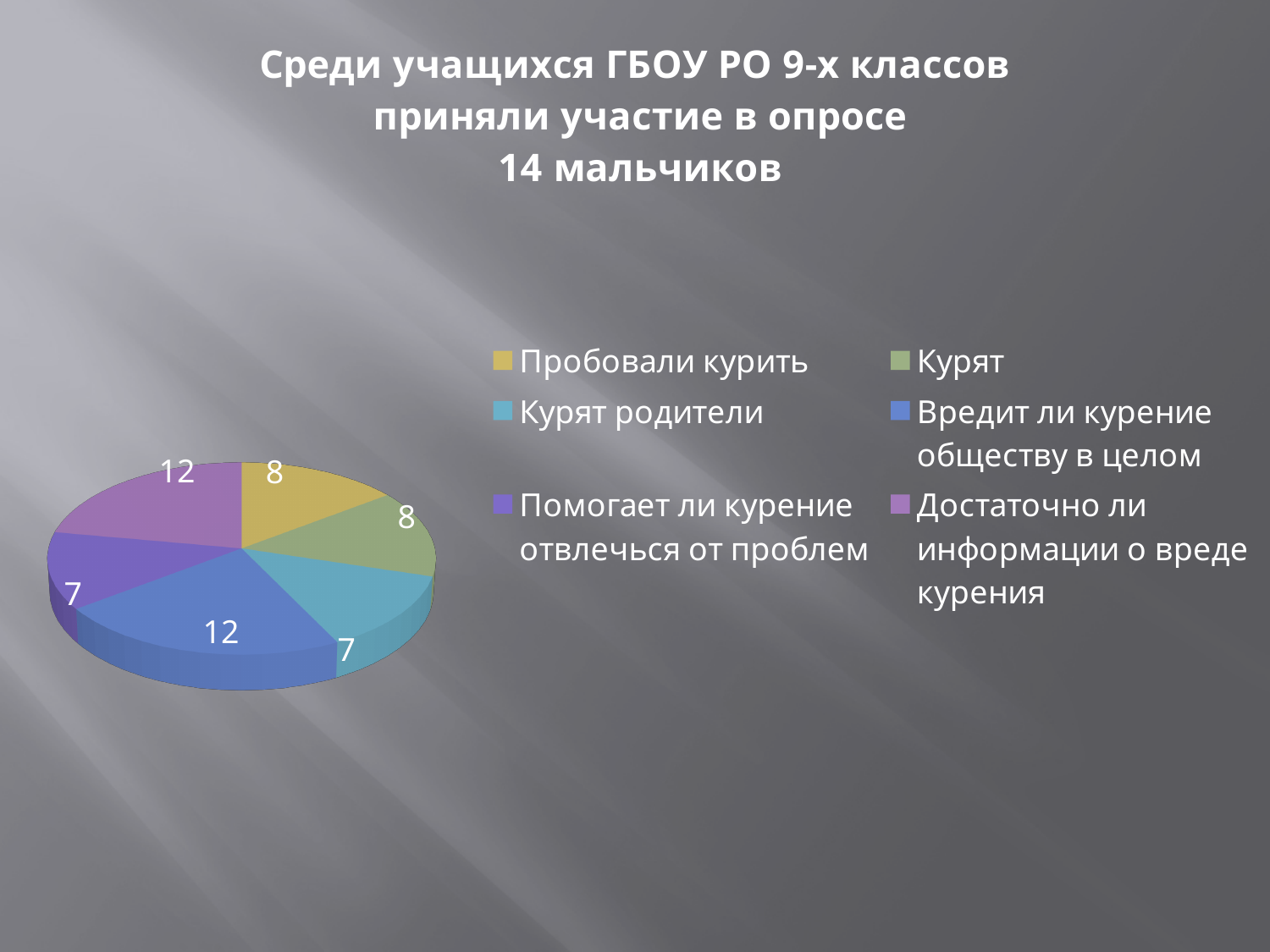
What is the value for "Вредит ли курение обществу в целом" in the pie chart? 12 Which colour represents "Пробовали курить" in the pie chart legend? yellow How many slices does the pie chart have? 6 What is the sum of all the values shown in the pie chart? 54 What is the value for "Пробовали курить" in the pie chart? 8 What type of chart is shown on the slide? pie chart What is the difference between the value for "Достаточно ли информации о вреде курения" and the value for "Помогает ли курение отвлечься от проблем"? 5 What is the value for "Курят" in the pie chart? 8 What is the value for "Помогает ли курение отвлечься от проблем" in the pie chart? 7 What is the value for "Курят родители" in the pie chart? 7 Which is larger: the value for "Вредит ли курение обществу в целом" or the value for "Курят родители"? Вредит ли курение обществу в целом What is the value for "Достаточно ли информации о вреде курения" in the pie chart? 12